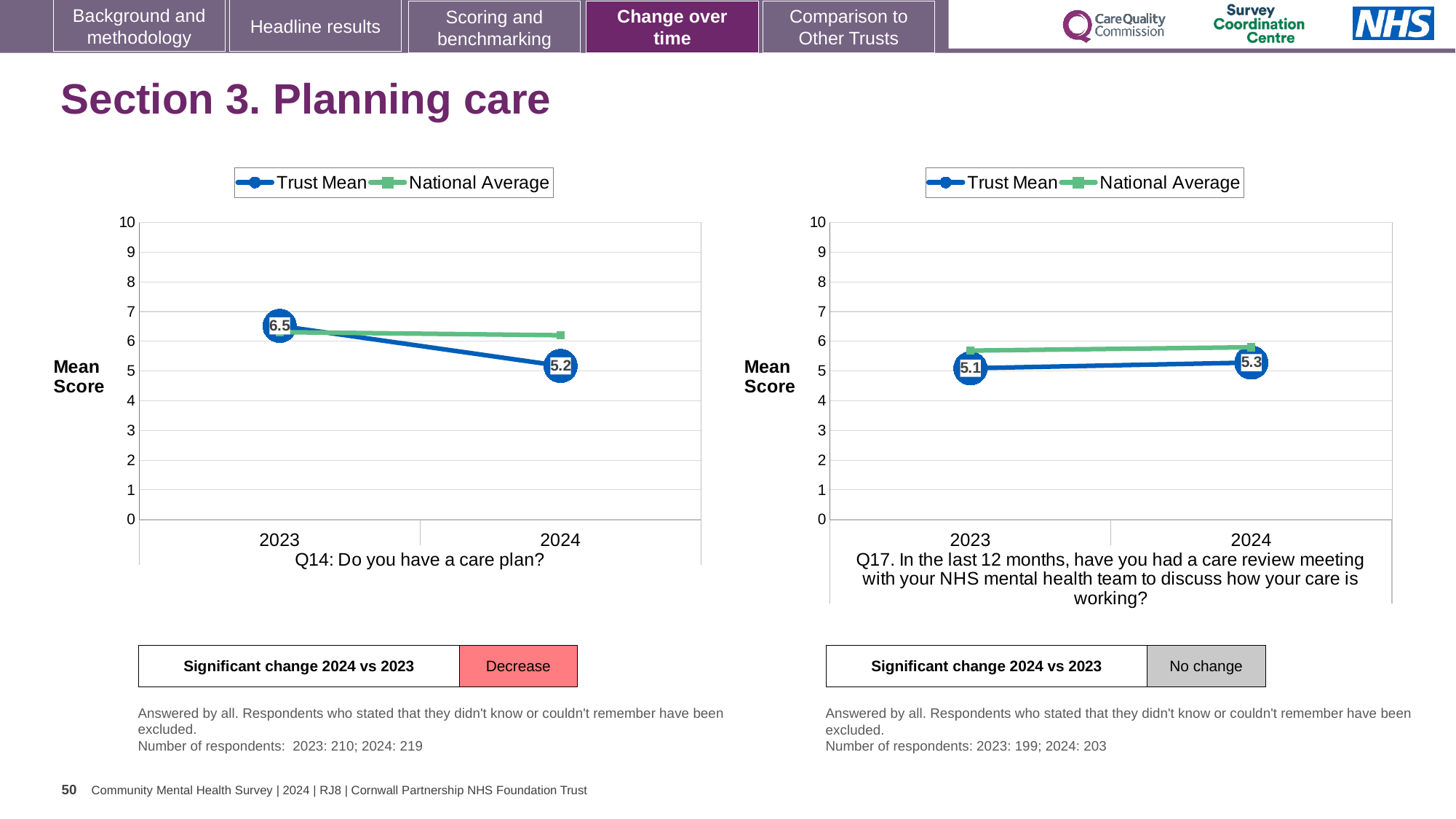
In the Q14 chart (left), does the Trust Mean rise or fall from 2023 to 2024? fall In the Q17 chart (right), what is the difference between the Trust Mean in 2024 and 2023? 0.2 What kind of chart is the Q14 chart on the left? line chart In the Q17 chart (right), what is the Trust Mean score for 2023? 5.1 In the Q14 chart (left), what is the Trust Mean score for 2023? 6.5 How many series does the legend of the Q17 chart (right) list? 2 In the Q17 chart (right), is the National Average for 2024 greater or less than 5? greater In the Q14 chart (left), which is larger in 2024: the Trust Mean or the National Average? National Average In the Q14 chart (left), what is the Trust Mean score for 2024? 5.2 In the Q17 chart (right), what is the Trust Mean score for 2024? 5.3 In the Q14 chart (left), by how much did the Trust Mean fall from 2023 to 2024? 1.3 In the Q17 chart (right), does the Trust Mean rise or fall from 2023 to 2024? rise